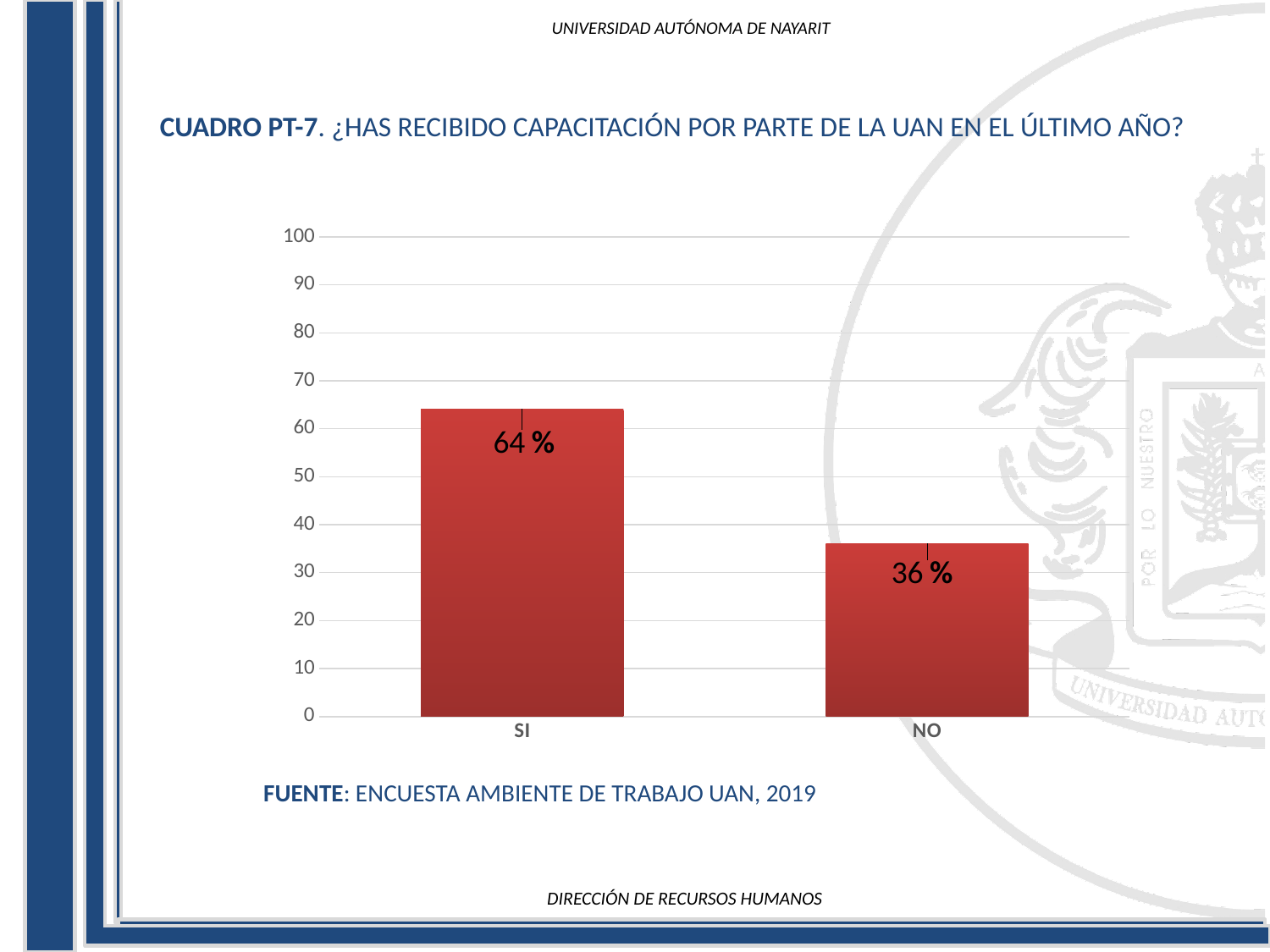
Is the value for SI greater or less than 50? greater Which is larger, the value for SI or the value for NO? SI How many categories are shown on the x axis? 2 What kind of chart is shown on the slide? bar chart What is the value for NO? 36 % What source is cited below the chart? ENCUESTA AMBIENTE DE TRABAJO UAN, 2019 What is the maximum value shown on the vertical axis? 100 Which category has the lowest value? NO What is the difference between the values for SI and NO? 28 % What is the value for SI? 64 % Which category has the highest value? SI Is the value for NO greater or less than 40? less